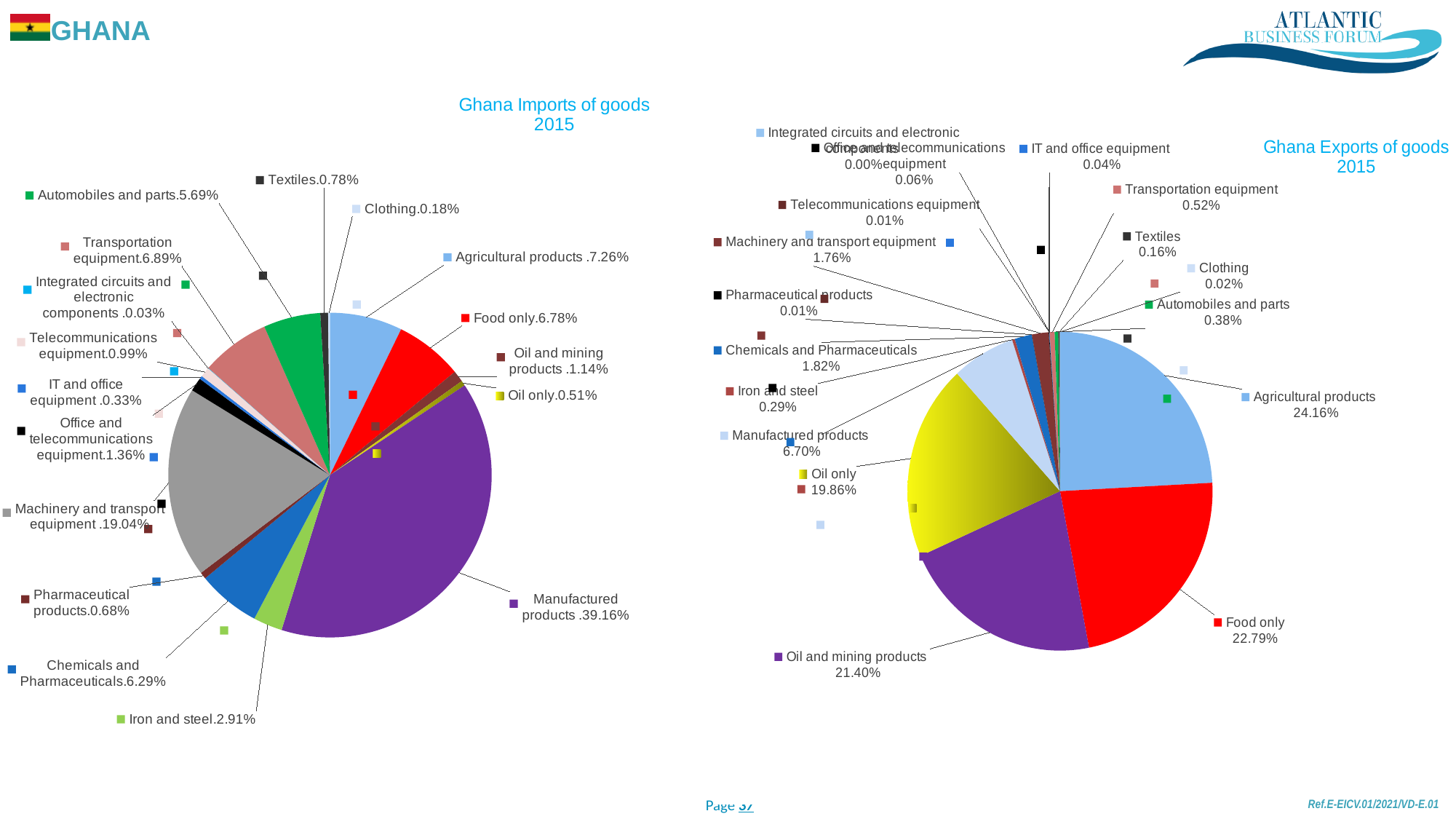
On the Ghana Exports of goods 2015 chart, which category has the largest share? Agricultural products On the Ghana Imports of goods 2015 chart, which category has the smallest share? Integrated circuits and electronic components How many categories are shown on the Ghana Imports of goods 2015 chart? 17 What kind of chart is the Ghana Exports of goods 2015 chart? Pie chart On the Ghana Imports of goods 2015 chart, what is the value for Machinery and transport equipment? 19.04% On the Ghana Imports of goods 2015 chart, what is the difference between Agricultural products and Food only? 0.48% On the Ghana Exports of goods 2015 chart, what is the difference between Food only and Oil and mining products? 1.39% On the Ghana Exports of goods 2015 chart, what is the value for Agricultural products? 24.16% On the Ghana Imports of goods 2015 chart, which is larger: Transportation equipment or Automobiles and parts? Transportation equipment On the Ghana Imports of goods 2015 chart, which category has the largest share? Manufactured products On the Ghana Imports of goods 2015 chart, what share do Manufactured products have? 39.16% On the Ghana Exports of goods 2015 chart, what share does Oil only have? 19.86%